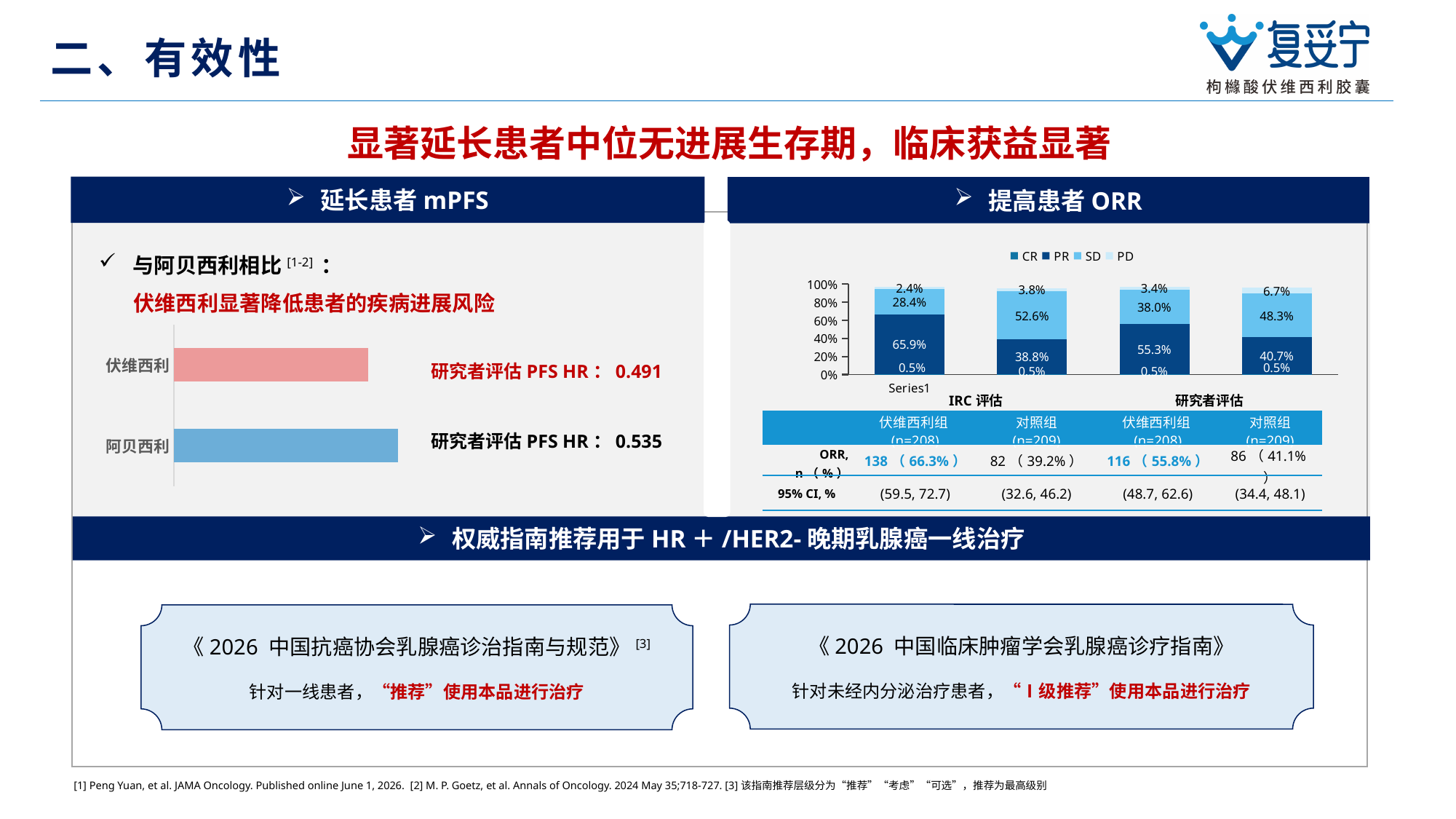
In the 提高患者 ORR chart, what is the PR value for the first (leftmost) bar? 65.9% In the 提高患者 ORR chart, what is the SD value for the second bar from the left? 52.6% In the 提高患者 ORR chart, which bar has the highest PD value? The fourth (rightmost) bar, 6.7% In the 提高患者 ORR chart, how many stacked bars are plotted? 4 In the 延长患者 mPFS chart on the left, which bar is longer, 伏维西利 or 阿贝西利? 阿贝西利 In the 提高患者 ORR chart, what is the difference between the PR value of the first bar and the PR value of the second bar? 27.1 percentage points In the 提高患者 ORR chart, what are the legend entries? CR, PR, SD, PD In the 提高患者 ORR chart, what is the PD value for the third bar from the left? 3.4% In the 提高患者 ORR chart, how many series does the legend list? 4 What kind of chart is shown in the 提高患者 ORR panel on the right? Stacked bar chart In the 提高患者 ORR chart, is the SD value larger in the third bar or the fourth bar? The fourth bar (48.3%) In the 延长患者 mPFS chart on the left, what is the 研究者评估 PFS HR shown for 伏维西利? 0.491